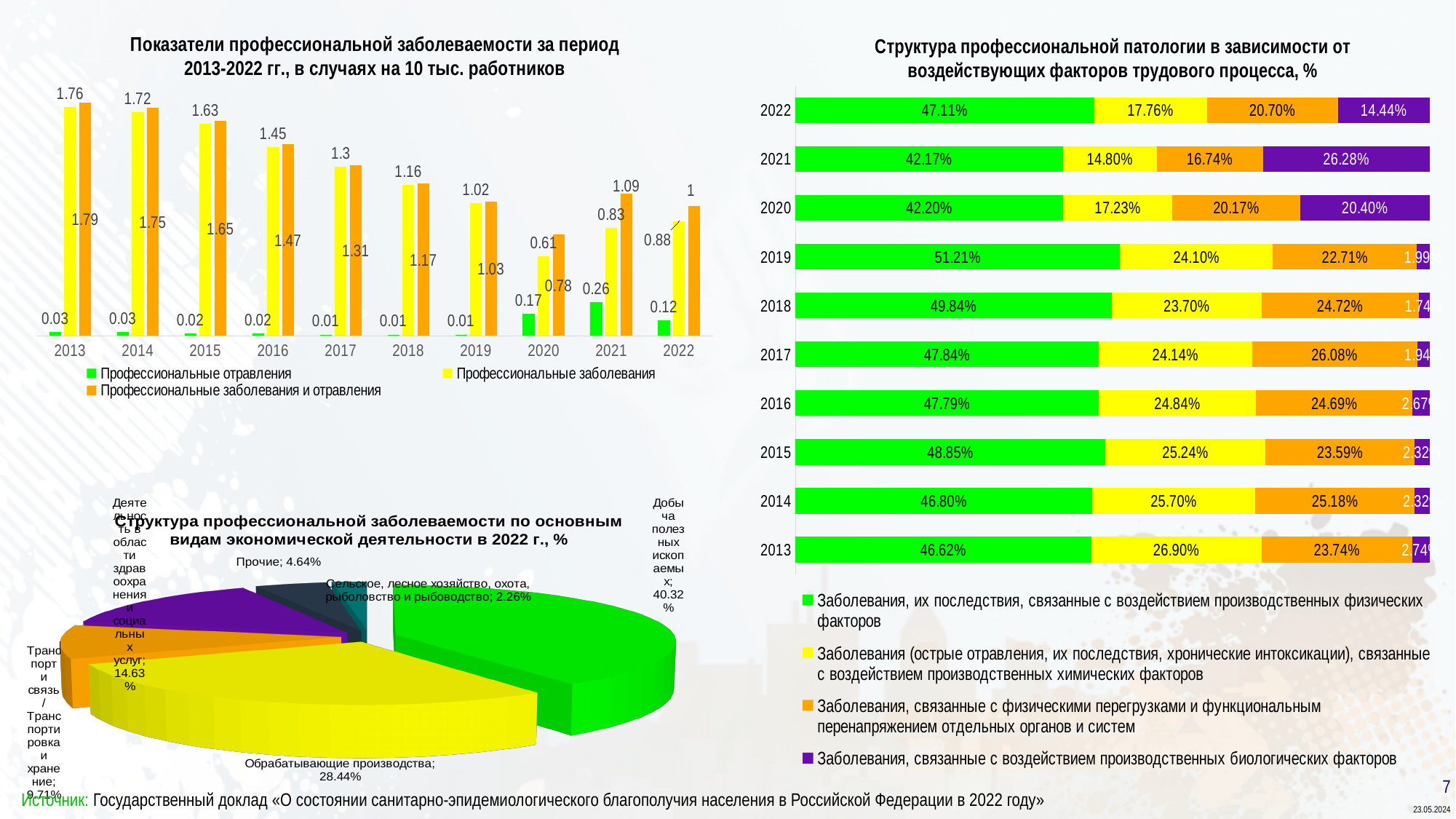
In the chart 'Показатели профессиональной заболеваемости за период 2013-2022 гг.', which year has the lowest value for 'Профессиональные заболевания'? 2020 In the chart 'Показатели профессиональной заболеваемости за период 2013-2022 гг.', what is the difference between the 'Профессиональные заболевания и отравления' values for 2013 and 2022? 0.79 What kind of chart is 'Структура профессиональной заболеваемости по основным видам экономической деятельности в 2022 г., %'? Pie chart In the chart 'Показатели профессиональной заболеваемости за период 2013-2022 гг.', which year has the highest value for 'Профессиональные заболевания и отравления'? 2013 In the chart 'Показатели профессиональной заболеваемости за период 2013-2022 гг.', what is the value for 'Профессиональные заболевания' in 2013? 1.76 In the chart 'Структура профессиональной патологии в зависимости от воздействующих факторов трудового процесса, %', which is larger: the chemical factors (yellow) share in 2013 or in 2022? 2013 In the chart 'Структура профессиональной патологии в зависимости от воздействующих факторов трудового процесса, %', what is the share of diseases related to biological factors (purple) in 2021? 26.28% How many years are shown in the chart 'Структура профессиональной патологии в зависимости от воздействующих факторов трудового процесса, %'? 10 In the pie chart 'Структура профессиональной заболеваемости по основным видам экономической деятельности в 2022 г., %', what is the share of 'Обрабатывающие производства'? 28.44% In the chart 'Структура профессиональной патологии в зависимости от воздействующих факторов трудового процесса, %', what is the share of diseases related to physical factors (green) in 2019? 51.21% How many series does the legend of the chart 'Показатели профессиональной заболеваемости за период 2013-2022 гг.' list? 3 In the chart 'Показатели профессиональной заболеваемости за период 2013-2022 гг.', what is the value for 'Профессиональные отравления' in 2021? 0.26